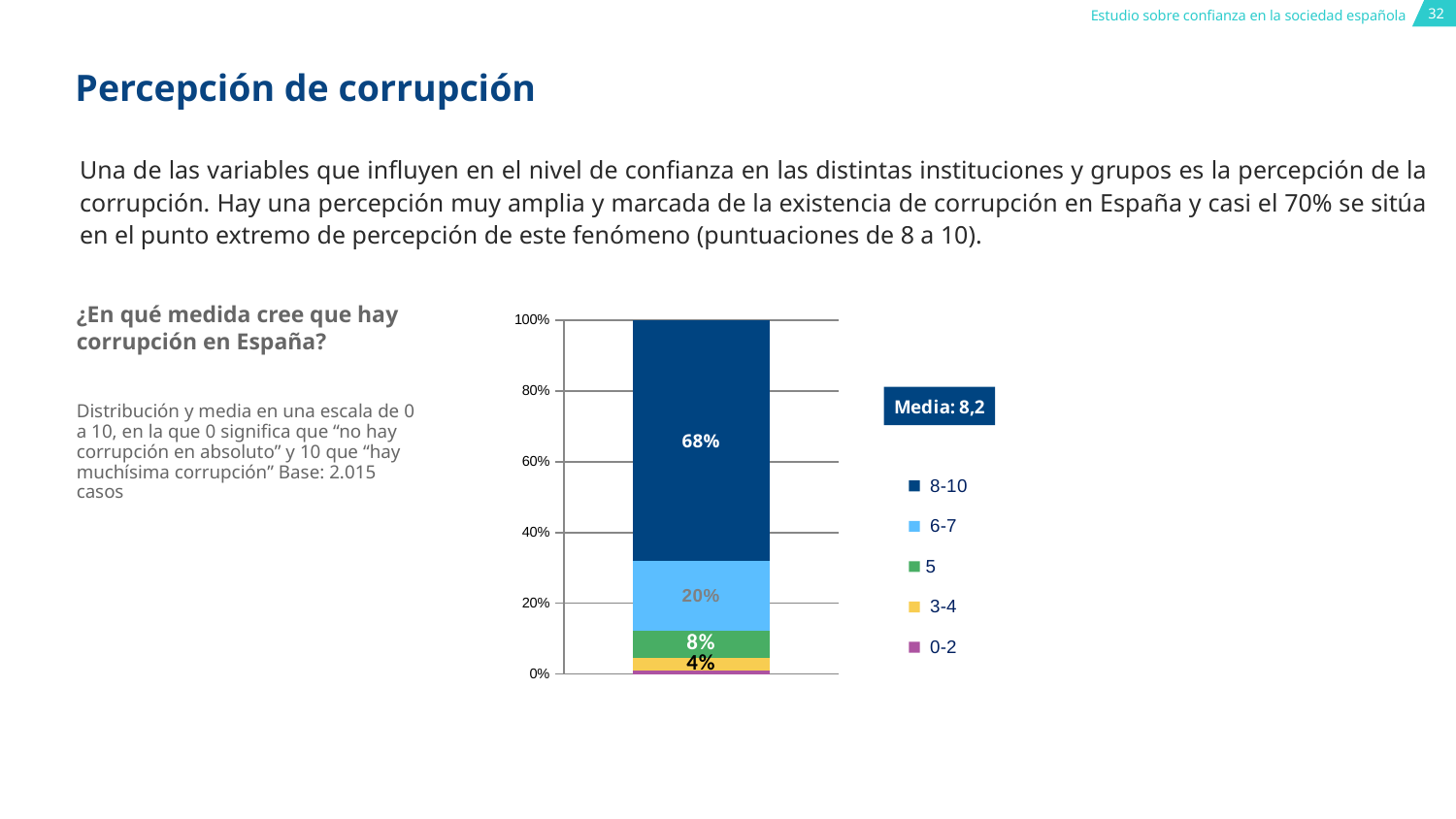
Which score range has the largest share of the stacked bar? 8-10 How many score ranges does the legend list? 5 What is the difference in percentage points between the 8-10 segment and the 6-7 segment? 48 percentage points What is the value of the 3-4 segment? 4% What percentage is shown for the segment labelled 5? 8% What mean score (Media) is shown next to the chart? 8,2 What is the value shown for the 6-7 segment of the stacked bar? 20% Which is larger, the 6-7 segment or the 5 segment? 6-7 Is the value for the 0-2 segment greater or less than 20%? less What percentage of respondents gave a score of 8-10 on the corruption perception scale? 68% Which score range has the smallest share of the stacked bar? 0-2 What kind of chart is shown on the slide? Stacked bar chart